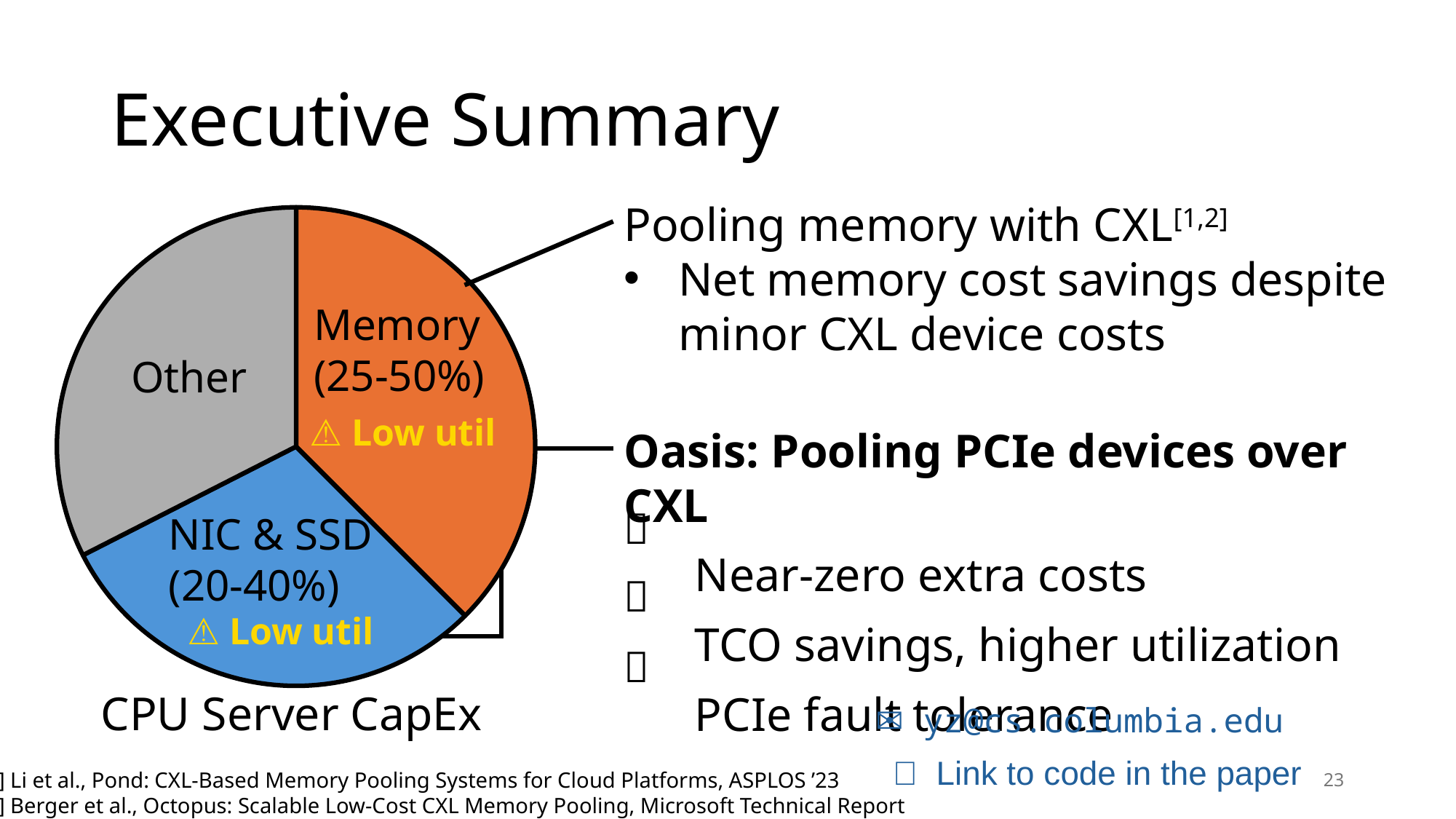
What percentage range is printed for the Memory slice? 25-50% Which slices of the pie chart are marked with a 'Low util' warning? Memory and NIC & SSD What percentage range is printed for the NIC & SSD slice? 20-40% Which slice is larger, Memory or NIC & SSD? Memory What is the title of the pie chart? CPU Server CapEx How many slices does the pie chart have? 3 Which slice of the pie chart is the largest? Memory What kind of chart is shown on the slide? pie chart Which slice of the pie chart is the smallest? NIC & SSD